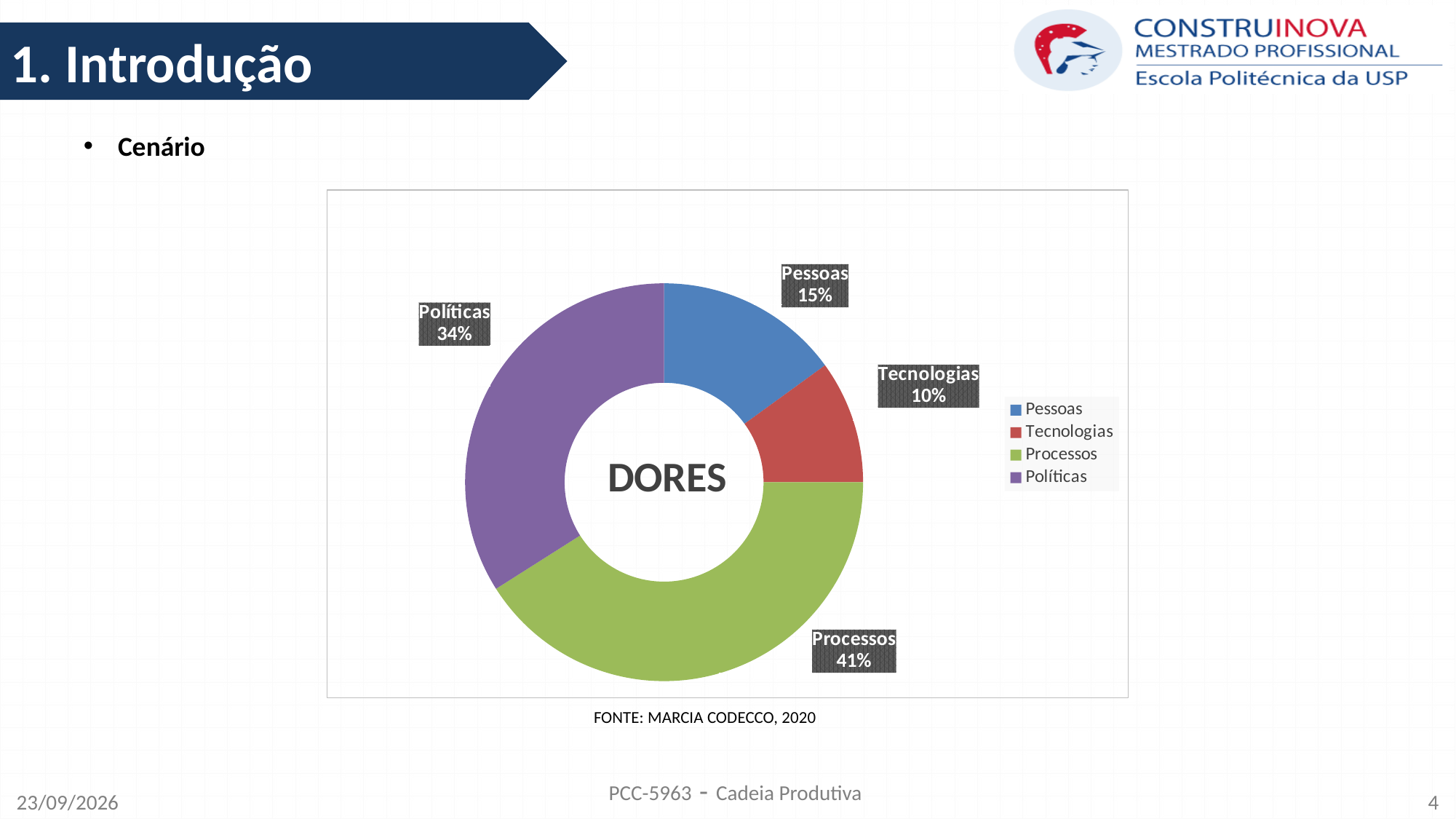
Which is larger, the share for Pessoas or the share for Tecnologias? Pessoas How many categories are shown in the chart? 4 What kind of chart is shown on the slide? Doughnut chart What percentage does the Processos slice represent? 41% What colour is the Políticas slice? Purple What percentage does the Políticas slice represent? 34% What is the difference in percentage points between Processos and Políticas? 7 What word is written in the centre of the doughnut chart? DORES Which category has the largest share of the chart? Processos What percentage does the Tecnologias slice represent? 10% What percentage does the Pessoas slice represent? 15% Which category has the smallest share of the chart? Tecnologias